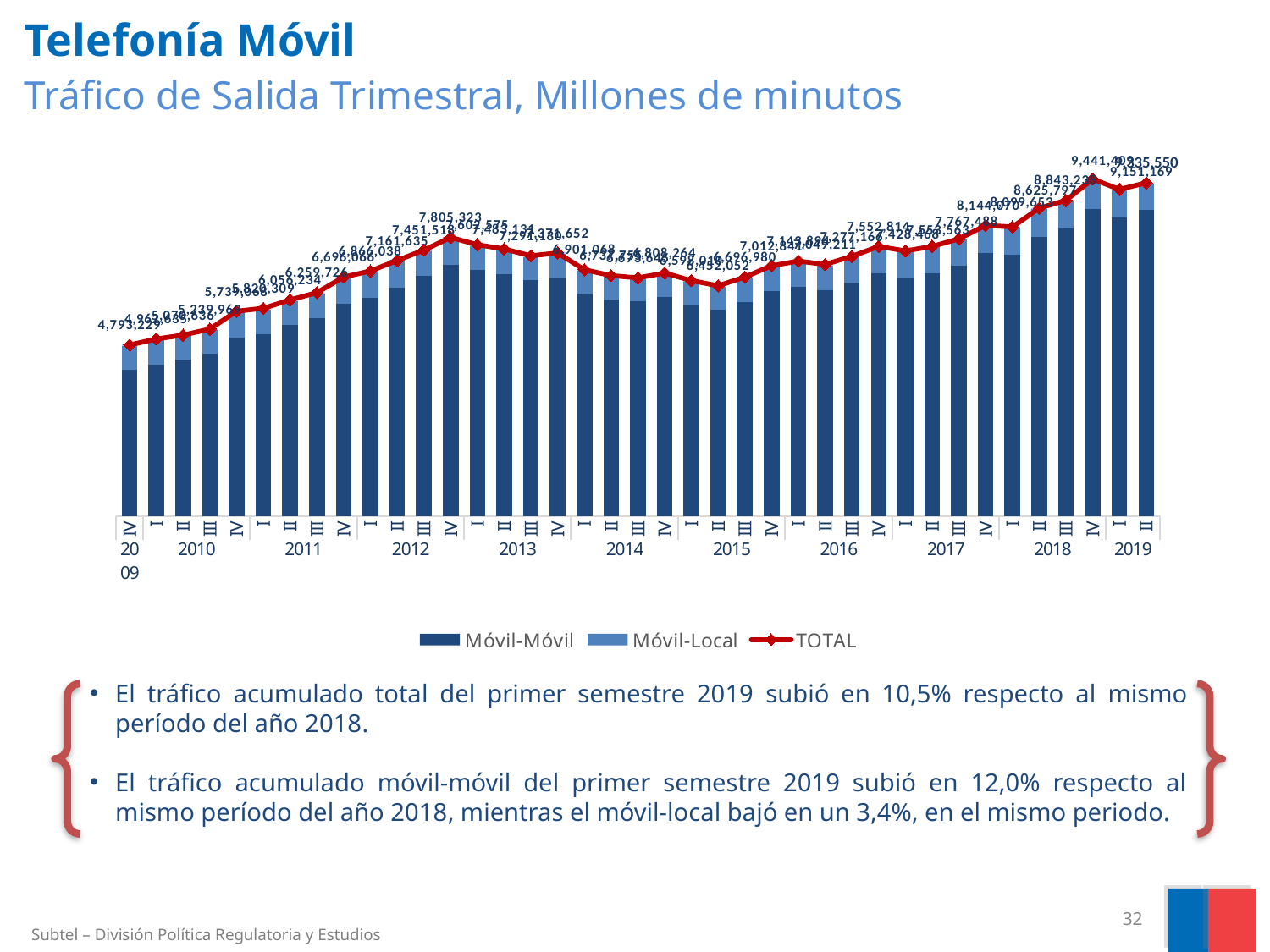
Which is larger in every quarter, the Móvil-Móvil segment or the Móvil-Local segment? Móvil-Móvil What kind of chart is shown on the slide? A stacked bar chart with a line In which quarter is the TOTAL lowest? IV 2009 What is the TOTAL value for quarter IV of 2012? 7,805,323 What is the difference between the TOTAL for quarter IV of 2012 and quarter IV of 2009? 3,012,094 What is the TOTAL value for quarter III of 2017? 7,767,488 What is the TOTAL value for quarter I of 2012? 6,866,038 Does the TOTAL line rise or fall between quarter IV of 2012 and quarter II of 2015? Fall How many series does the legend list? 3 What are the three series named in the legend? Móvil-Móvil, Móvil-Local, TOTAL In which quarter is the TOTAL highest? IV 2018 What is the TOTAL value for quarter IV of 2009? 4,793,229